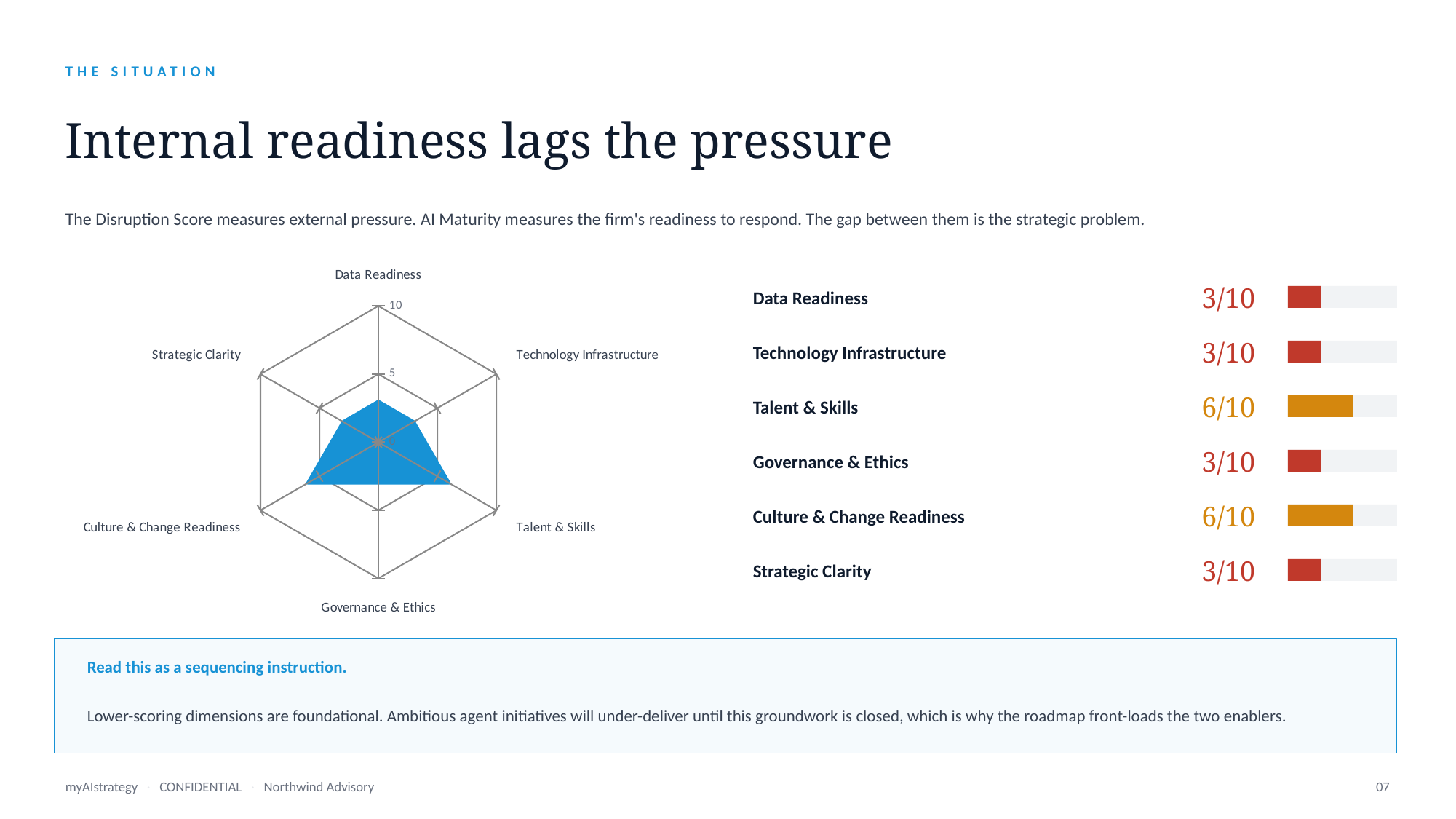
How many dimensions (axes) does the radar chart have? 6 What is the difference between the Talent & Skills score and the Strategic Clarity score? 3 What is the score for Data Readiness? 3/10 Is the value for Talent & Skills on the radar chart greater or less than 5? greater What is the score for Governance & Ethics? 3/10 Is the value for Strategic Clarity on the radar chart greater or less than 5? less What is the score for Culture & Change Readiness? 6/10 Which is larger, the score for Culture & Change Readiness or the score for Technology Infrastructure? Culture & Change Readiness Which dimensions have the highest score? Talent & Skills and Culture & Change Readiness What is the score for Talent & Skills? 6/10 What is the maximum value shown on the radar chart's axis? 10 What kind of chart is shown on the left of the slide? radar chart